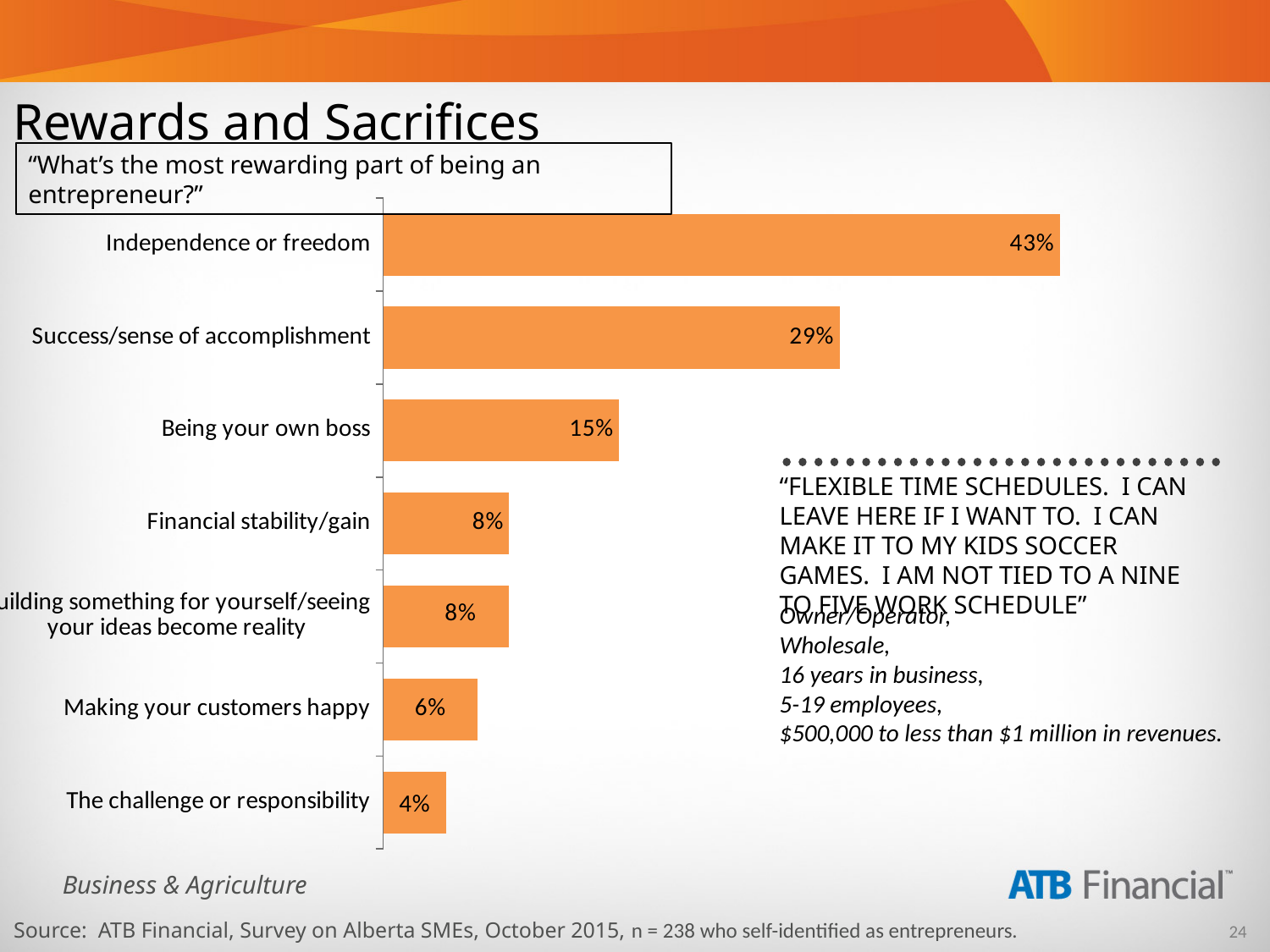
Which is larger: the value for "Being your own boss" or the value for "Financial stability/gain"? Being your own boss Do the bar values increase or decrease going from the top category to the bottom category? Decrease What is the difference between the values for "Independence or freedom" and "Success/sense of accomplishment"? 14 percentage points What percentage of respondents said "Independence or freedom" is the most rewarding part of being an entrepreneur? 43% Which category has the lowest value in the chart? The challenge or responsibility What value is shown for "Making your customers happy"? 6% What value is shown for "Being your own boss"? 15% What value is shown for "Success/sense of accomplishment"? 29% How many categories are shown in the chart? 7 What kind of chart is shown on the slide? Bar chart Which category has the highest value in the chart? Independence or freedom What survey question does the chart present responses to? "What's the most rewarding part of being an entrepreneur?"